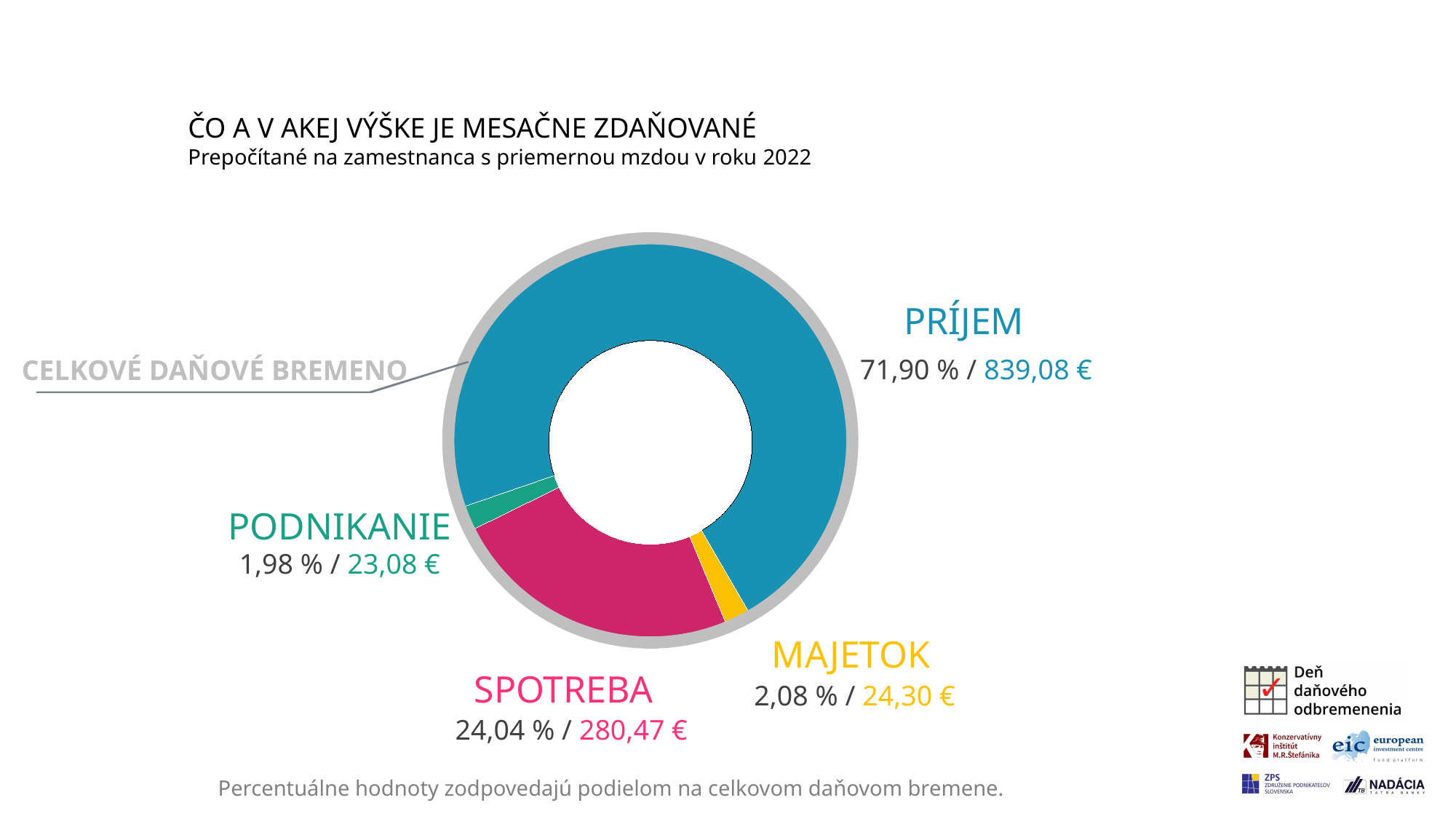
What percentage share does PODNIKANIE have? 1,98 % Which is larger in euros, MAJETOK or PODNIKANIE? MAJETOK Which category has the largest share of the pie? PRÍJEM Which category has the smallest share of the pie? PODNIKANIE What is the monthly amount in euros for SPOTREBA? 280,47 € What type of chart is shown on the slide? Pie chart (donut) How many categories does the pie chart show? 4 What is the difference in percentage points between PRÍJEM and SPOTREBA? 47,86 % What percentage share does PRÍJEM have? 71,90 % What is the monthly amount in euros for MAJETOK? 24,30 € What is the difference in euros between PRÍJEM and SPOTREBA? 558,61 € What label is attached to the grey outer ring of the chart? CELKOVÉ DAŇOVÉ BREMENO